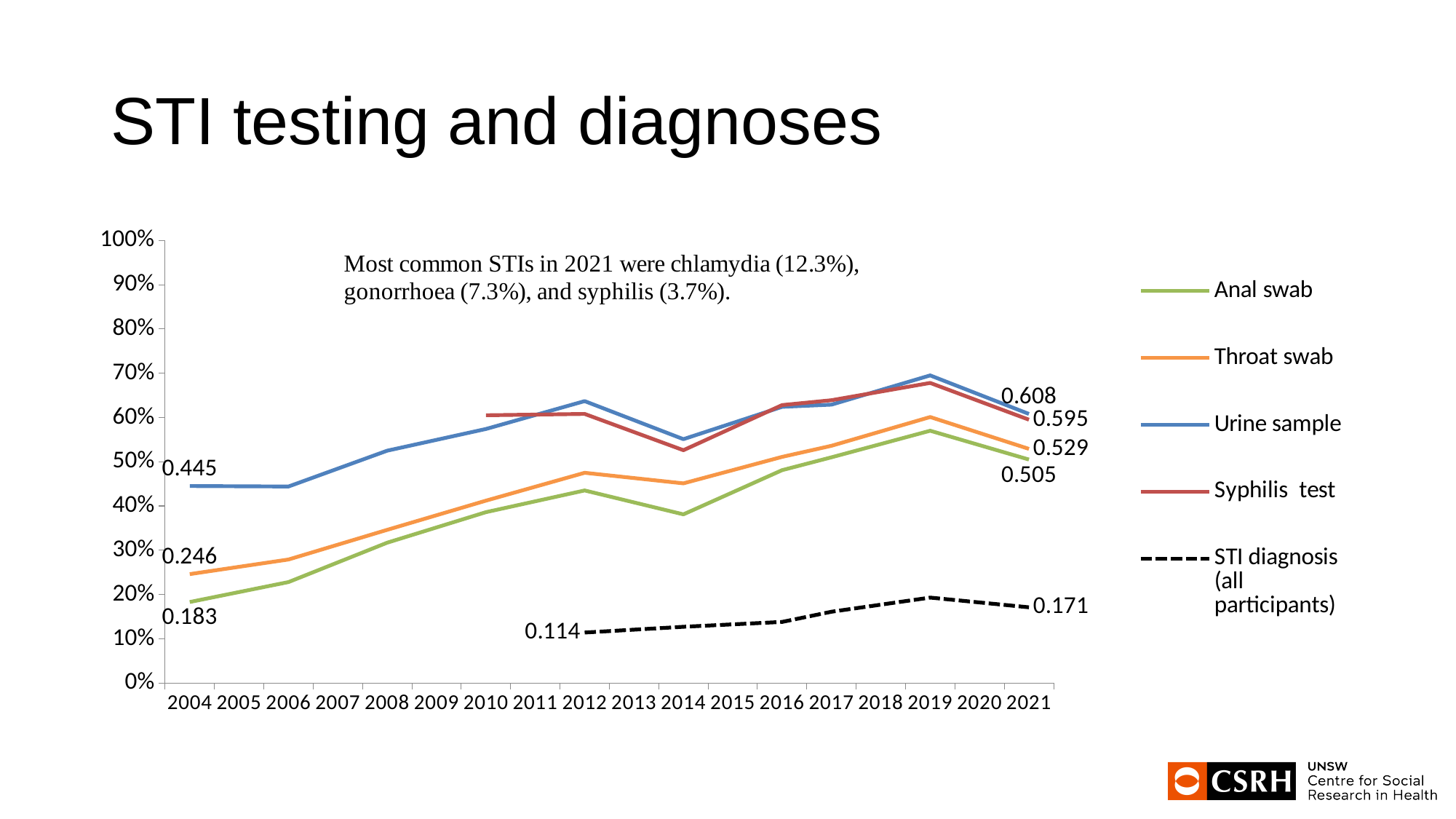
What is the difference between the Throat swab and Anal swab values in 2021? 0.024 Does the Anal swab line generally rise or fall from 2004 to 2019? rise What is the value for Urine sample in 2021? 0.608 What is the value for Anal swab in 2004? 0.183 What is the value for Throat swab in 2004? 0.246 What is the value for Syphilis test in 2021? 0.595 How many series does the legend list? 5 Is the value for Urine sample in 2019 greater or less than 60%? greater What is the value for STI diagnosis (all participants) in 2021? 0.171 What is the value for Urine sample in 2004? 0.445 What type of chart is shown on the slide? line chart Which series has the highest value in 2021? Urine sample